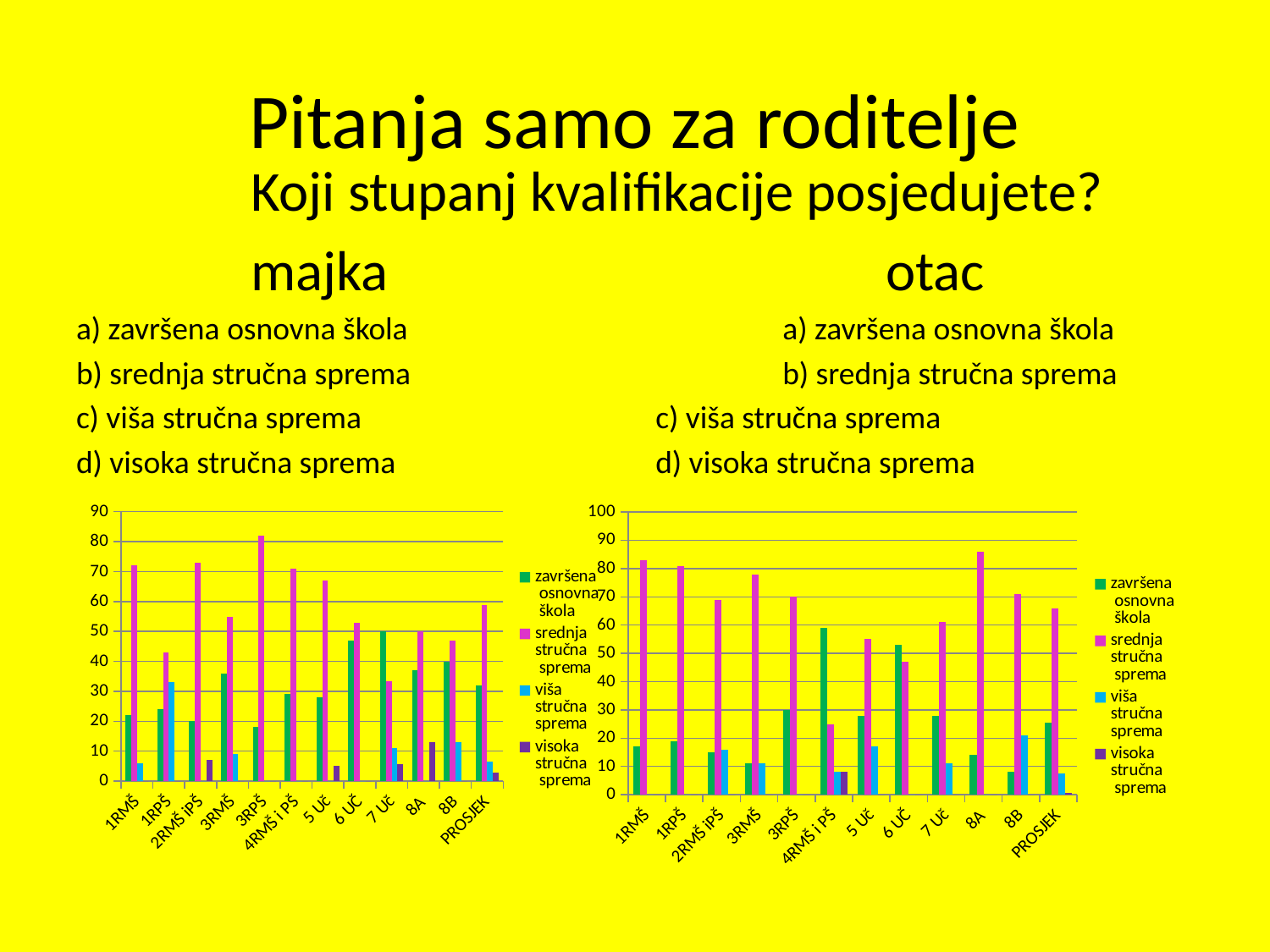
In the left chart (majka), is the value for srednja stručna sprema at 3RPŠ greater or less than 70? greater In the right chart (otac), which category has the highest value for završena osnovna škola? 4RMŠ i PŠ In the left chart (majka), which is larger for srednja stručna sprema: 1RMŠ or 1RPŠ? 1RMŠ What kind of chart is the left chart (majka)? bar chart What is the last category on the x axis of the left chart (majka)? PROSJEK How many series does the legend of the left chart (majka) list? 4 How many categories are shown on the x axis of the right chart (otac)? 12 In the left chart (majka), is the value for završena osnovna škola at 1RMŠ greater or less than 30? less In the right chart (otac), which is larger for srednja stručna sprema: 8A or 8B? 8A In the right chart (otac), is the value for završena osnovna škola at 4RMŠ i PŠ greater or less than 50? greater In the left chart (majka), which category has the highest value for srednja stručna sprema? 3RPŠ